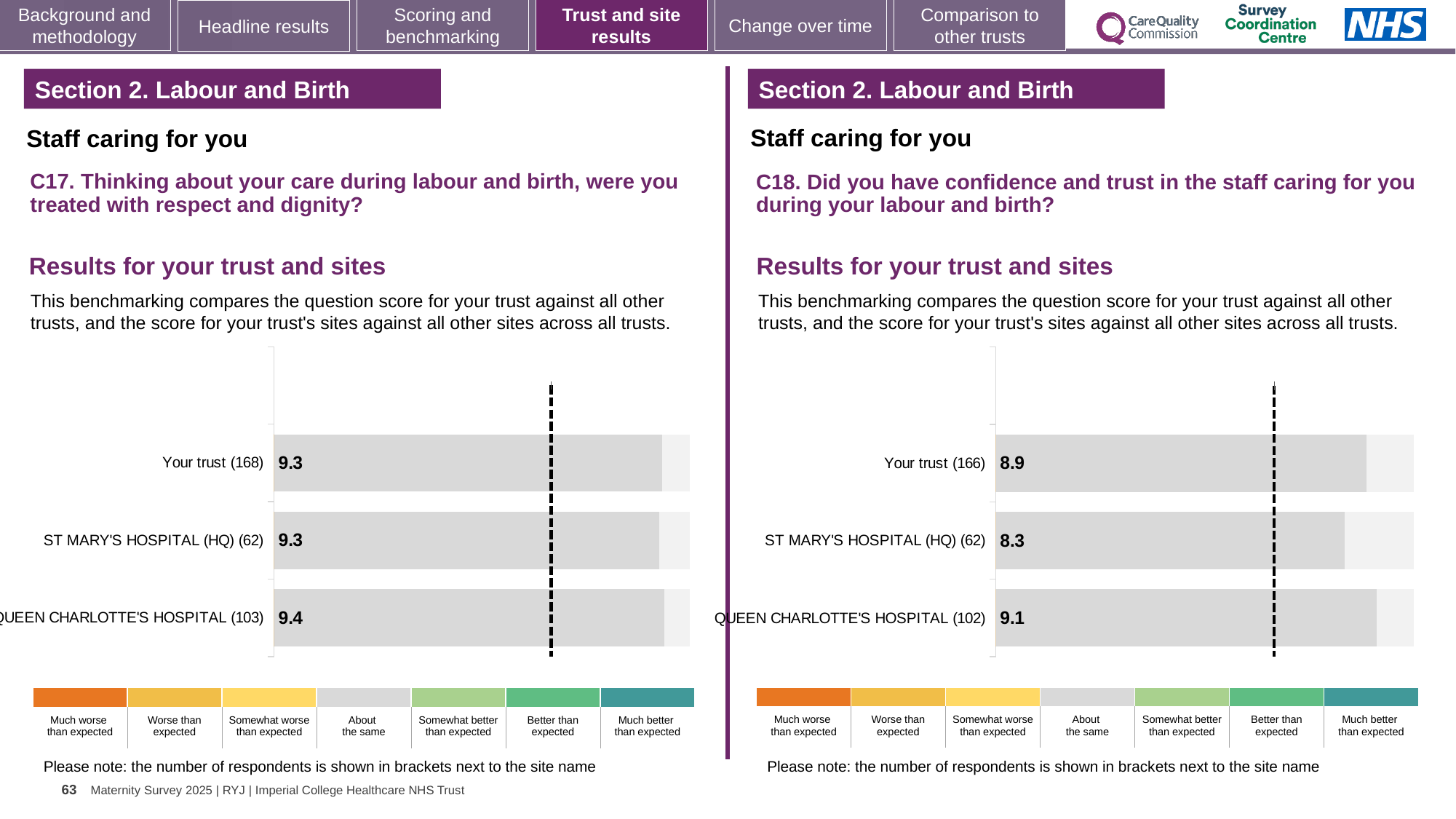
On the C18 chart (right), what is the score for QUEEN CHARLOTTE'S HOSPITAL (102)? 9.1 On the C18 chart (right), which has the larger score: Your trust (166) or QUEEN CHARLOTTE'S HOSPITAL (102)? QUEEN CHARLOTTE'S HOSPITAL (102) What kind of chart is used on the C17 chart (left)? Bar chart On the C17 chart (left), what is the score for QUEEN CHARLOTTE'S HOSPITAL (103)? 9.4 On the C18 chart (right), what is the score for ST MARY'S HOSPITAL (HQ) (62)? 8.3 On the C18 chart (right), how many categories does the colour key below the chart list? 7 On the C18 chart (right), which site or trust has the lowest score? ST MARY'S HOSPITAL (HQ) (62) On the C18 chart (right), what is the difference between the scores for QUEEN CHARLOTTE'S HOSPITAL (102) and ST MARY'S HOSPITAL (HQ) (62)? 0.8 On the C17 chart (left), how many bars are plotted? 3 On the C17 chart (left), which site or trust has the highest score? QUEEN CHARLOTTE'S HOSPITAL (103) On the C17 chart (left), what is the score for Your trust (168)? 9.3 On the C18 chart (right), what is the score for Your trust (166)? 8.9